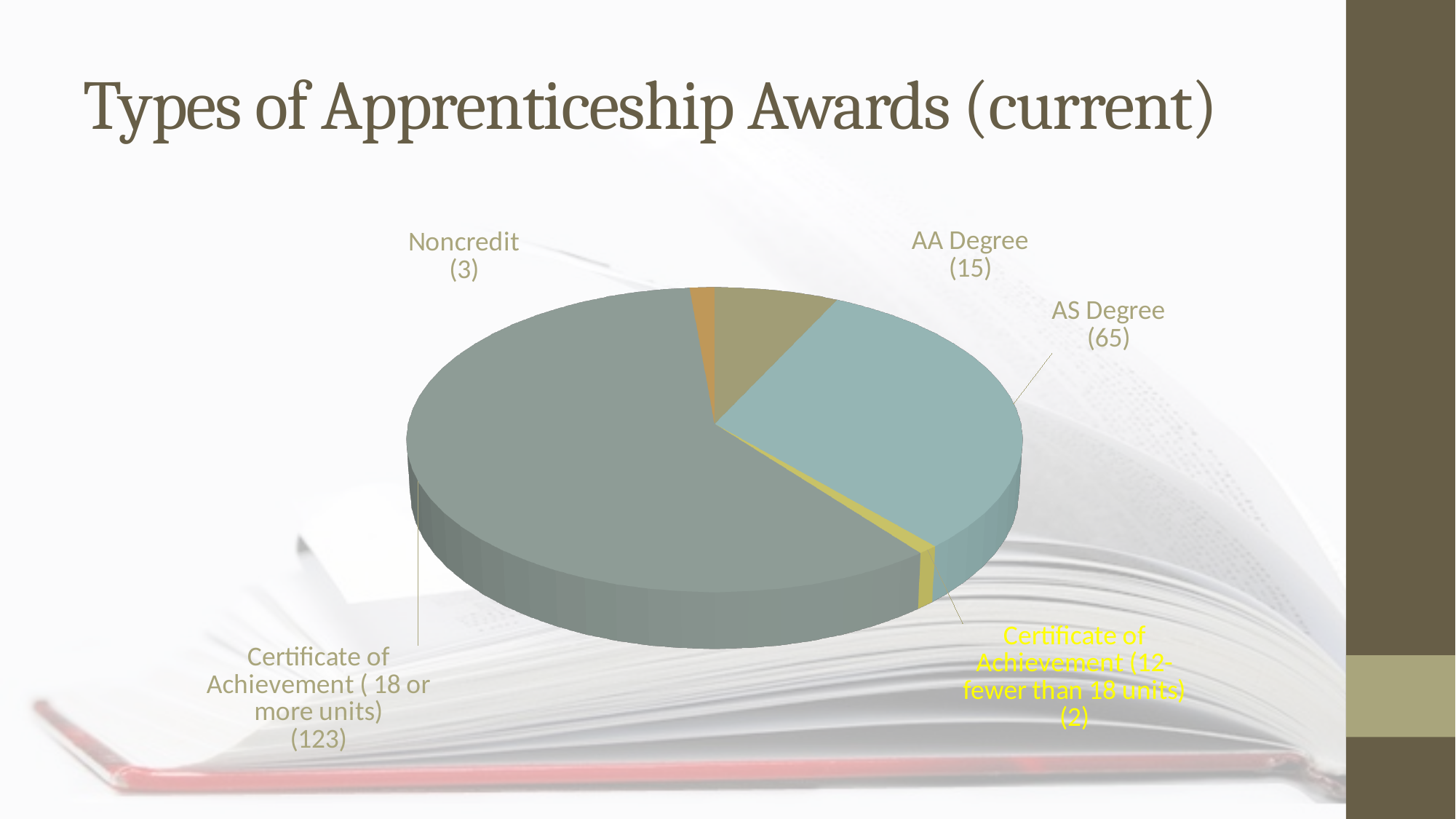
What is the value for Noncredit? 3 Which is larger, the value for AA Degree or the value for Noncredit? AA Degree Which category has the smallest slice of the pie? Certificate of Achievement (12-fewer than 18 units) What is the title of the chart on the slide? Types of Apprenticeship Awards (current) What is the value for AA Degree? 15 What is the difference between the values for AS Degree and AA Degree? 50 What is the value for Certificate of Achievement (18 or more units)? 123 How many slices does the pie chart have? 5 What is the difference between the values for Certificate of Achievement (18 or more units) and AS Degree? 58 Which category has the largest slice of the pie? Certificate of Achievement (18 or more units) What is the value for AS Degree? 65 What type of chart is shown on the slide? Pie chart